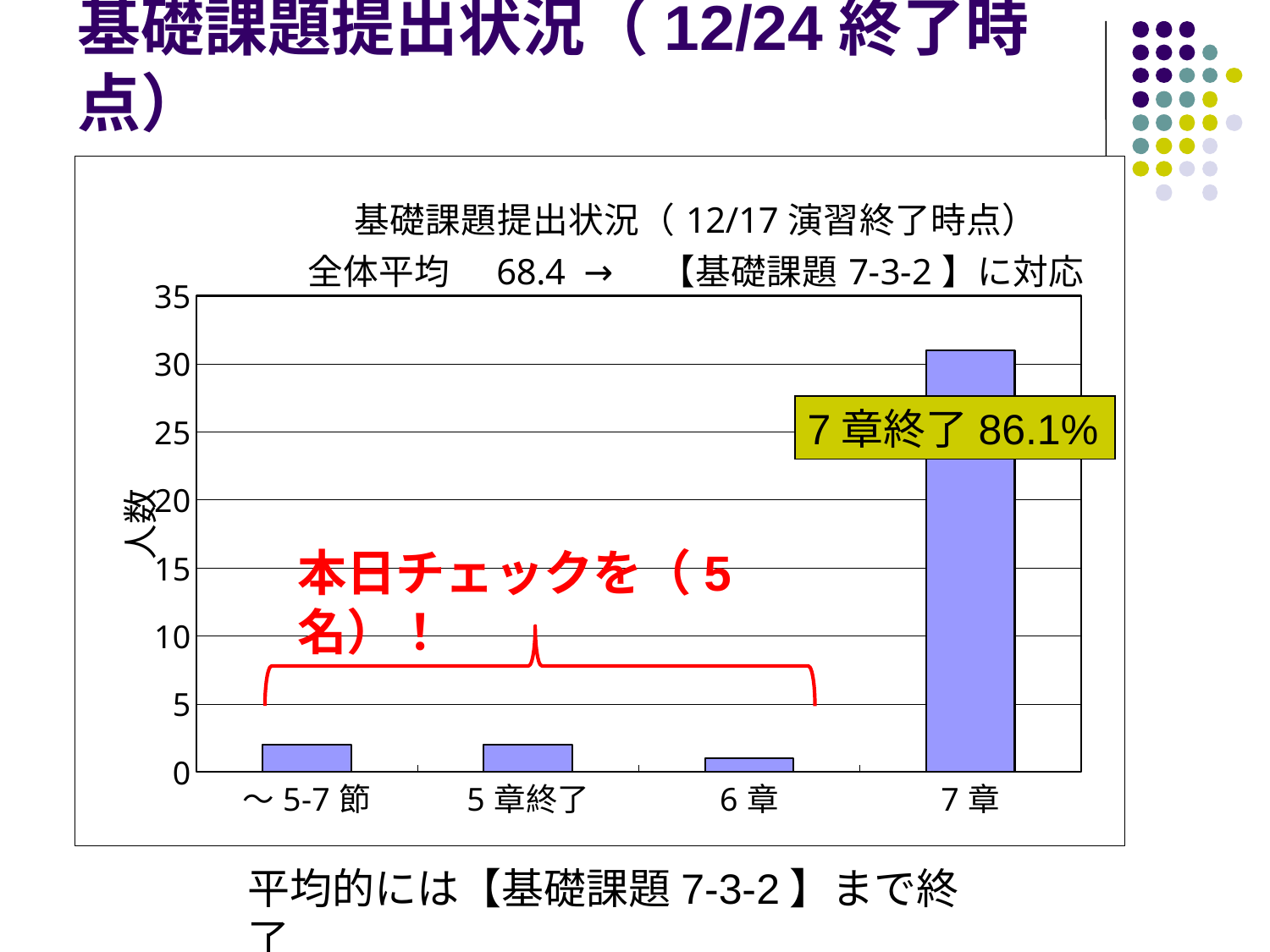
Is the value for 5章終了 greater or less than 5? less What percentage is shown in the yellow annotation box on the chart? 86.1% Is the value for 7章 greater or less than 25? greater What kind of chart is shown on the slide? bar chart Which is larger, the value for 7章 or the value for 6章? 7章 Which category has the lowest bar in the chart? 6章 Is the value for 6章 greater or less than 5? less Which category has the highest bar in the chart? 7章 How many categories are shown on the x axis of the chart? 4 What is the label of the y axis of the chart? 人数